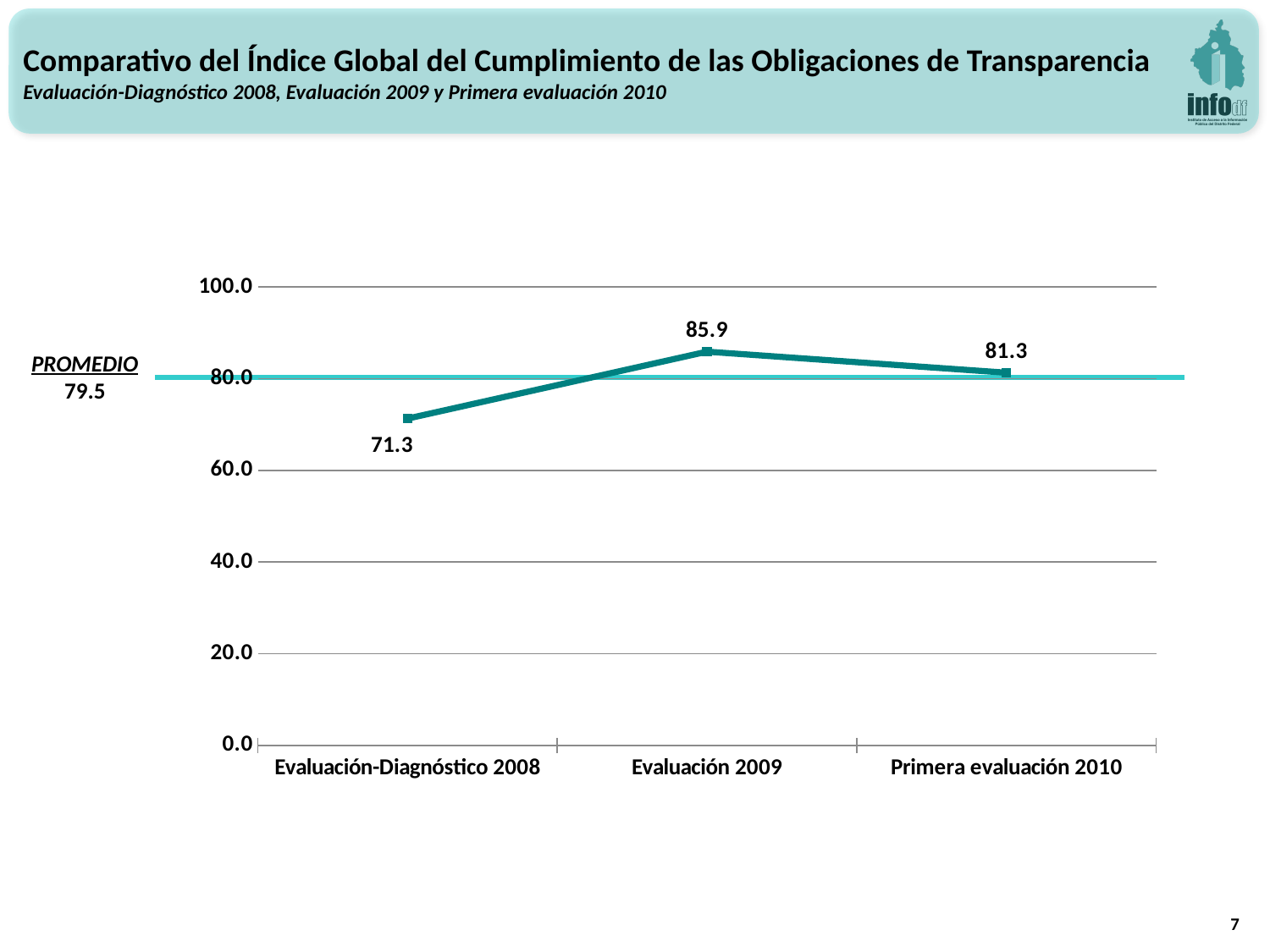
Which evaluation has the lowest value? Evaluación-Diagnóstico 2008 How many evaluations are plotted on the x axis? 3 Which evaluation has the highest value? Evaluación 2009 What is the value for Primera evaluación 2010? 81.3 Is the value for Evaluación-Diagnóstico 2008 greater or less than 80.0? less What is the value for Evaluación-Diagnóstico 2008? 71.3 Which is larger, the value for Primera evaluación 2010 or the value for Evaluación-Diagnóstico 2008? Primera evaluación 2010 What is the difference between the values for Evaluación 2009 and Primera evaluación 2010? 4.6 What is the PROMEDIO (average) value shown by the horizontal line? 79.5 What kind of chart is shown on the slide? line chart What is the value for Evaluación 2009? 85.9 What is the difference between the values for Evaluación 2009 and Evaluación-Diagnóstico 2008? 14.6